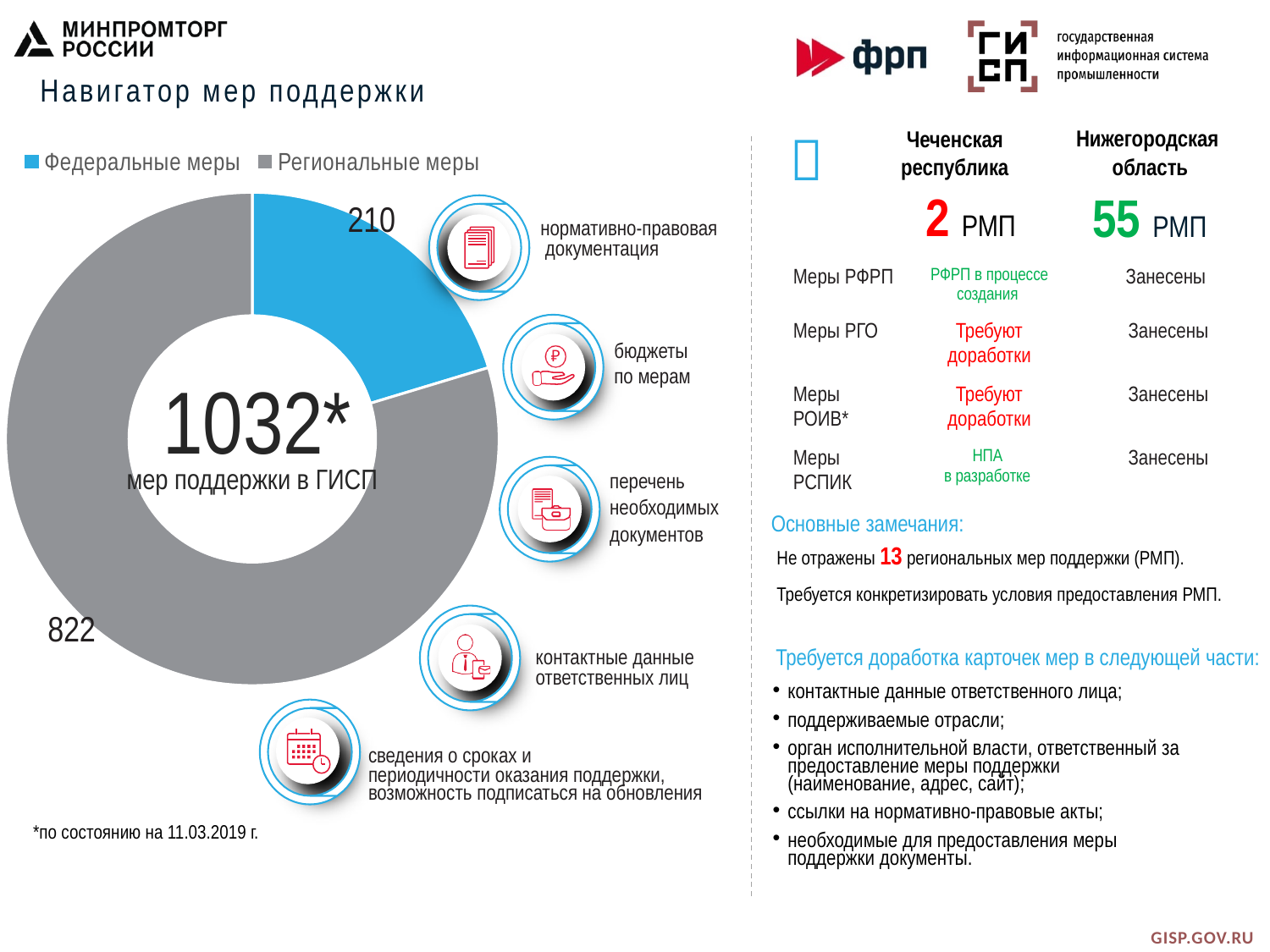
Which is larger: the value for "Федеральные меры" or for "Региональные меры"? Региональные меры What colour represents "Федеральные меры" in the donut chart? Blue What total number is shown in the centre of the donut chart? 1032* What is the value for "Федеральные меры" in the donut chart? 210 Which category has the smallest slice in the donut chart? Федеральные меры What is the value for "Региональные меры" in the donut chart? 822 How many entries does the chart legend list? 2 What is the title of the slide containing the donut chart? Навигатор мер поддержки How many categories does the donut chart have? 2 What type of chart is shown on the slide? Pie (donut) chart Which category has the largest slice in the donut chart? Региональные меры What is the difference between the values for "Региональные меры" and "Федеральные меры"? 612